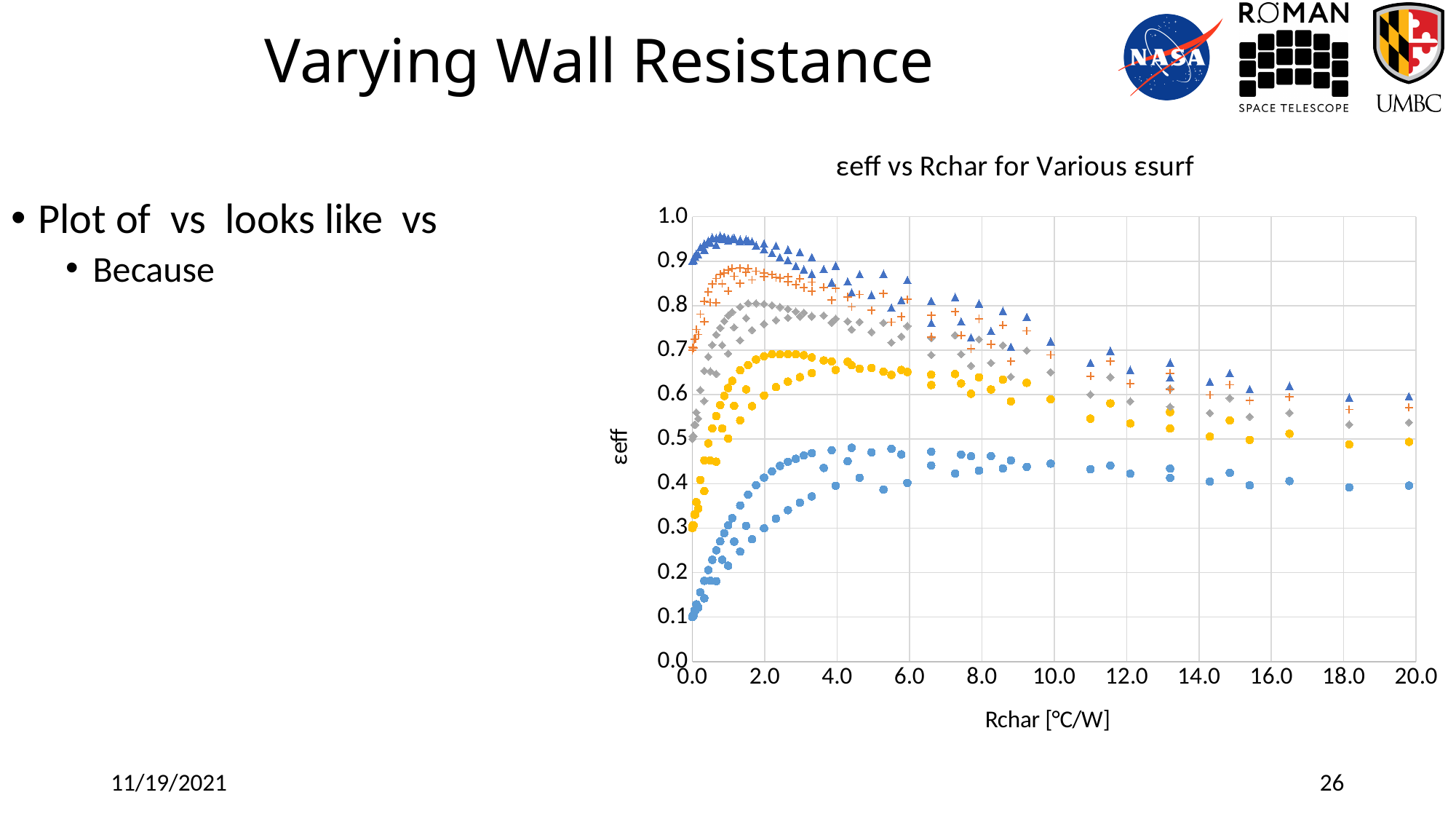
What kind of chart is shown on the slide? scatter chart At Rchar 20.0, which is larger: the blue triangle series or the blue circle series? blue triangle series Is the peak value of the orange plus-sign series greater or less than 0.8? greater Which marker series has the lowest εeff values across the chart? blue circles What is the title of the chart? εeff vs Rchar for Various εsurf Is the peak value of the blue triangle series greater or less than 0.9? greater Is the value of the blue circle series at Rchar 20.0 greater or less than 0.5? less Which marker series has the highest εeff values across the chart? blue triangles What is the label of the x axis of the chart? Rchar [°C/W] Do the values of the blue triangle series rise or fall as Rchar increases from 2.0 to 20.0? fall